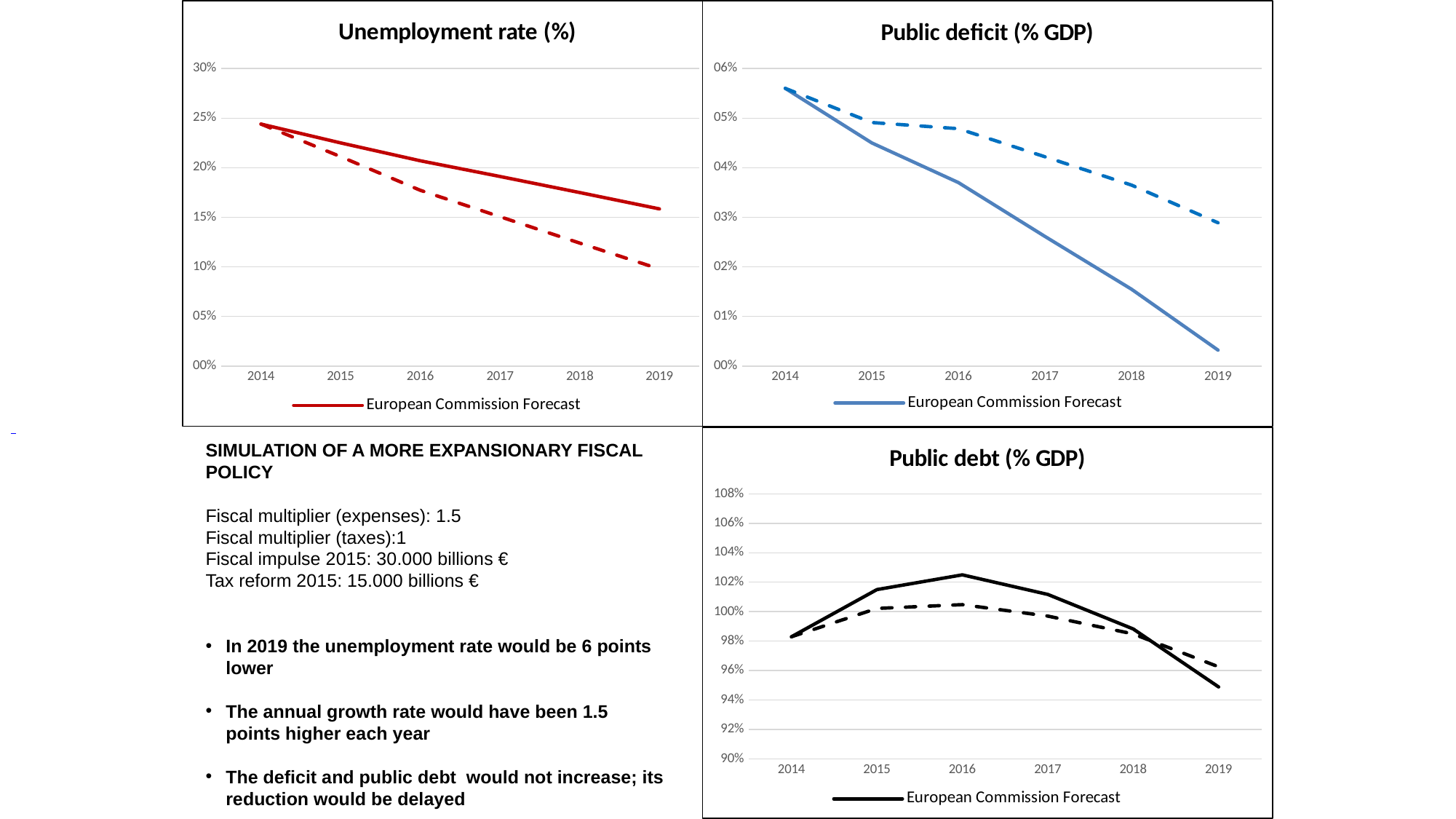
In the "Public deficit (% GDP)" chart, does the solid line rise or fall across the years? fall In the "Unemployment rate (%)" chart, is the solid line's value for 2019 greater or less than 15%? greater In the "Unemployment rate (%)" chart, which line is higher in 2019, the solid line or the dashed line? the solid line In the "Unemployment rate (%)" chart, how many years are shown on the x axis? 6 How many entries does the legend of the "Public debt (% GDP)" chart list? 1 In the "Public debt (% GDP)" chart, in which year does the solid line reach its highest value? 2016 In the "Public deficit (% GDP)" chart, is the solid line's value for 2019 greater or less than 01%? less In the "Public deficit (% GDP)" chart, is the dashed line's value for 2018 greater or less than 03%? greater In the "Unemployment rate (%)" chart, does the solid line rise or fall from 2014 to 2019? fall In the "Public debt (% GDP)" chart, in which year does the solid line reach its lowest value? 2019 What kind of chart is the "Unemployment rate (%)" chart? line chart